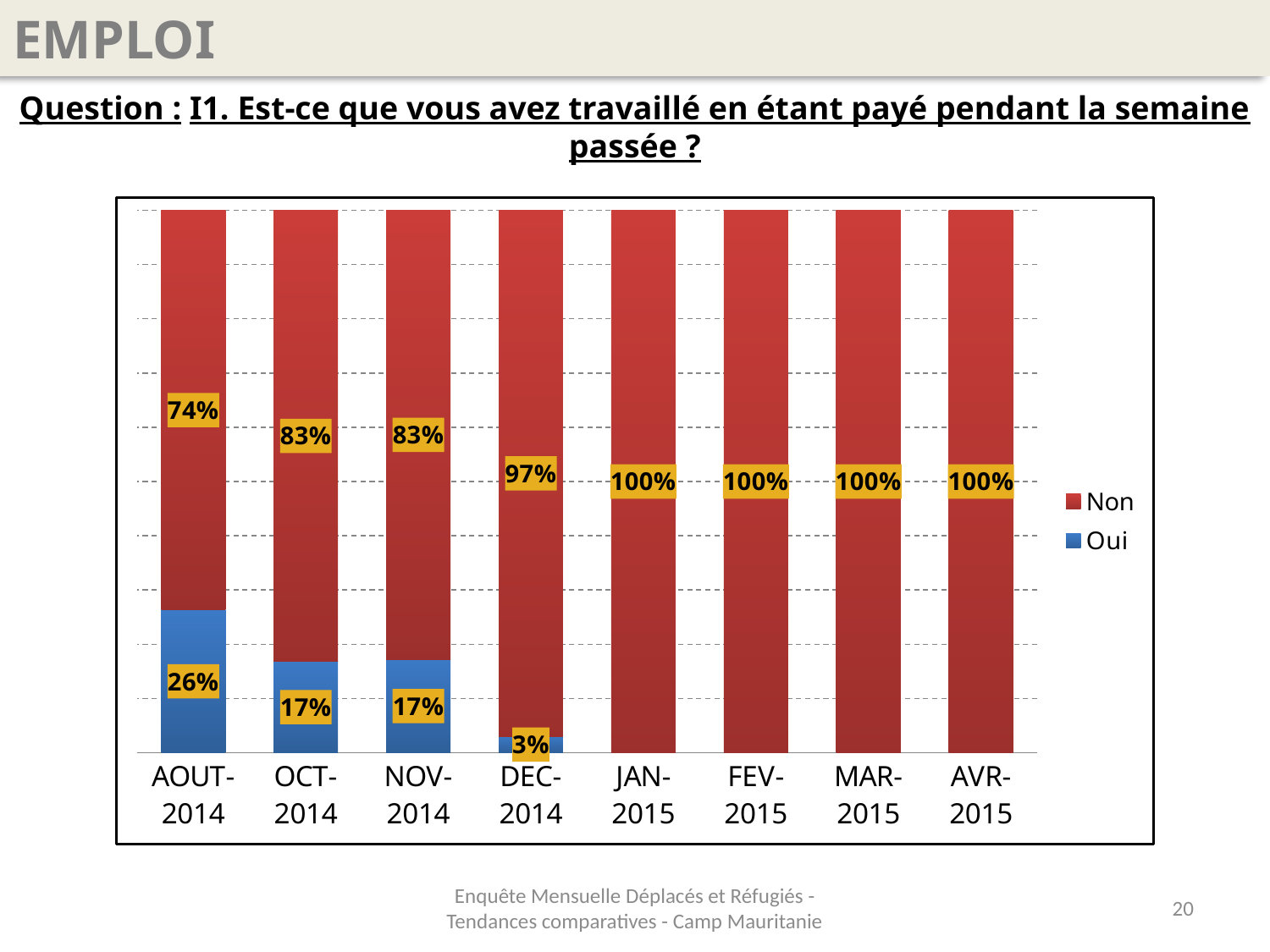
Which is larger: the Oui value in AOUT-2014 or the Oui value in NOV-2014? AOUT-2014 Which month has the lowest value for Non? AOUT-2014 How many months are shown on the x axis? 8 What is the difference between the Non value in DEC-2014 and the Non value in NOV-2014? 14% Which month has the highest value for Oui? AOUT-2014 What is the value for Non in AOUT-2014? 74% How many series does the legend list? 2 What is the value for Non in MAR-2015? 100% What is the value for Oui in DEC-2014? 3% What kind of chart is shown on the slide? Stacked bar chart What is the value for Non in DEC-2014? 97% What is the value for Oui in OCT-2014? 17%